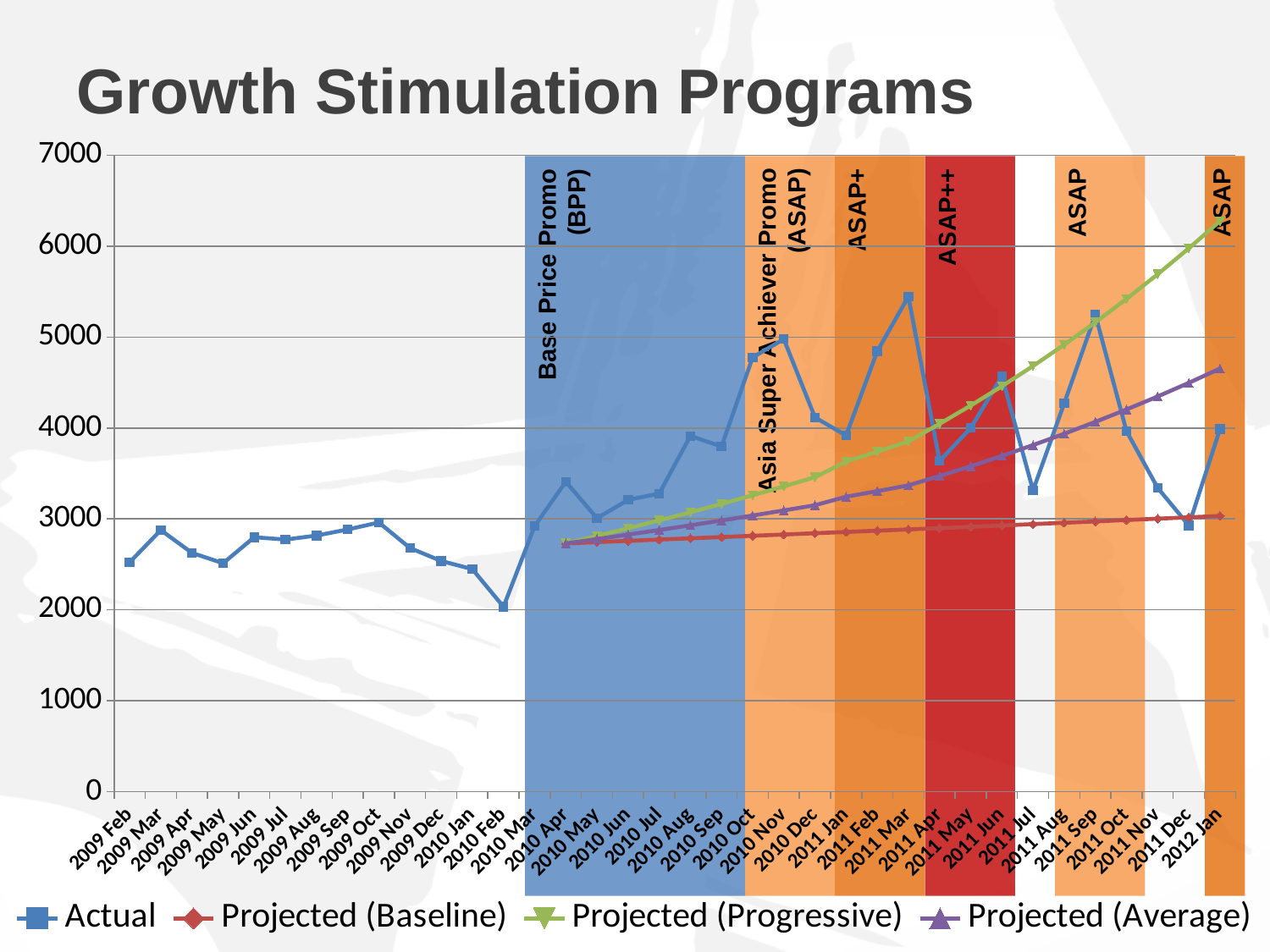
Is the Actual value for 2011 Jul greater or less than 3000? greater How many series does the legend list? 4 Is the Projected (Average) value for 2012 Jan greater or less than 5000? less Which is larger for the Actual series: 2011 Mar or 2011 Apr? 2011 Mar In which month is the Actual series at its lowest? 2010 Feb Is the Actual value for 2011 Mar greater or less than 5000? greater How many months are shown along the x axis? 36 What is the title of the chart? Growth Stimulation Programs Which is larger at 2012 Jan: Projected (Progressive) or Projected (Baseline)? Projected (Progressive) Does the Projected (Progressive) series rise or fall along the x axis? Rise What kind of chart is shown on the slide? Line chart